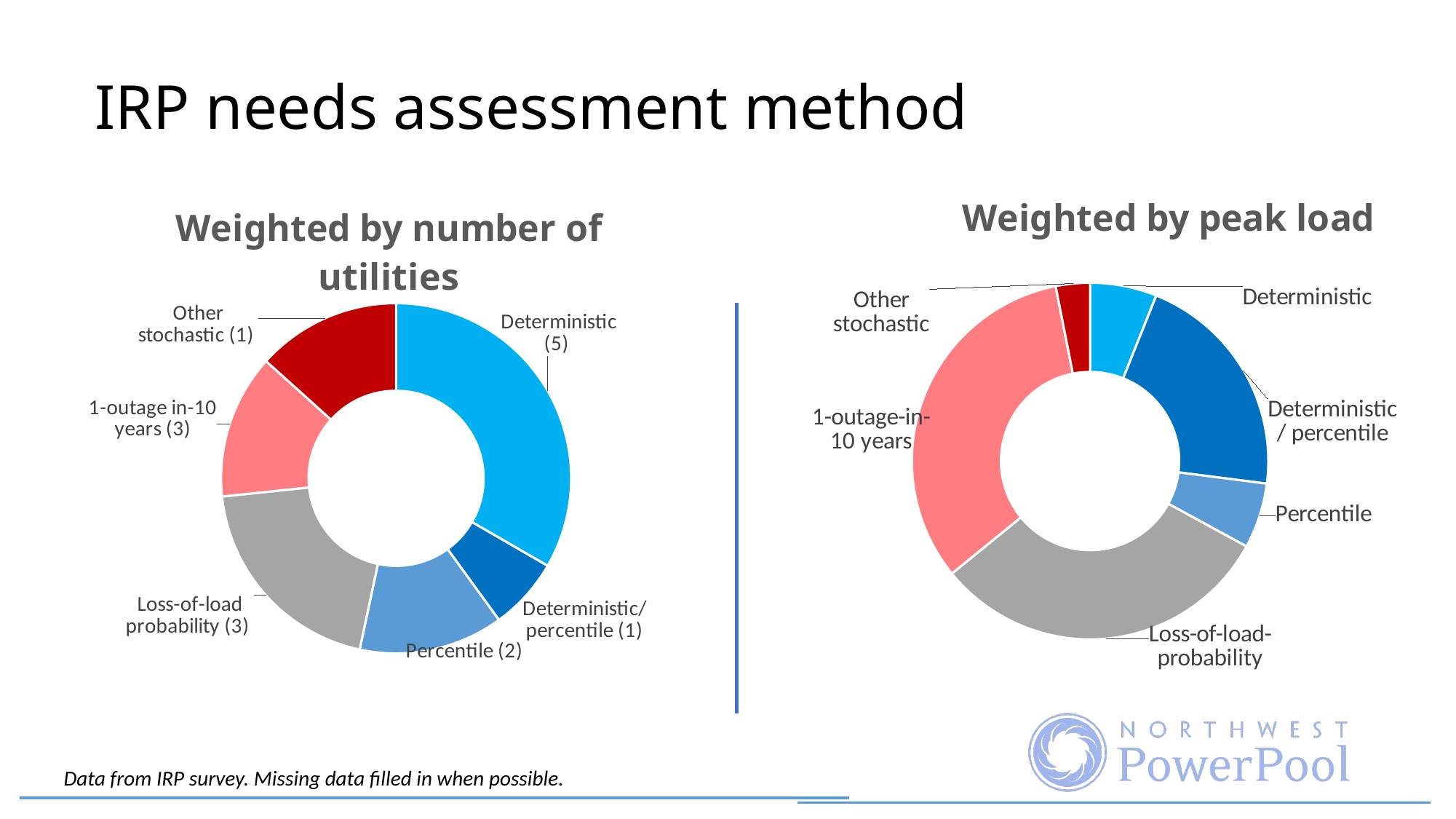
What is the title of the chart on the right side of the slide? Weighted by peak load On the 'Weighted by peak load' chart, which category has the largest share? 1-outage-in-10 years On the 'Weighted by number of utilities' chart, what is the value for Percentile? 2 On the 'Weighted by number of utilities' chart, which is larger: 1-outage in-10 years or Other stochastic? 1-outage in-10 years On the 'Weighted by number of utilities' chart, what is the difference between Deterministic and Percentile? 3 On the 'Weighted by number of utilities' chart, what is the value for Loss-of-load probability? 3 On the 'Weighted by peak load' chart, which category has the smallest share? Other stochastic How many categories are shown on the 'Weighted by number of utilities' chart? 6 On the 'Weighted by number of utilities' chart, what is the value for Deterministic? 5 What kind of chart is the 'Weighted by peak load' chart? Doughnut chart On the 'Weighted by peak load' chart, which is larger: Loss-of-load-probability or Deterministic? Loss-of-load-probability On the 'Weighted by number of utilities' chart, which category has the highest value? Deterministic